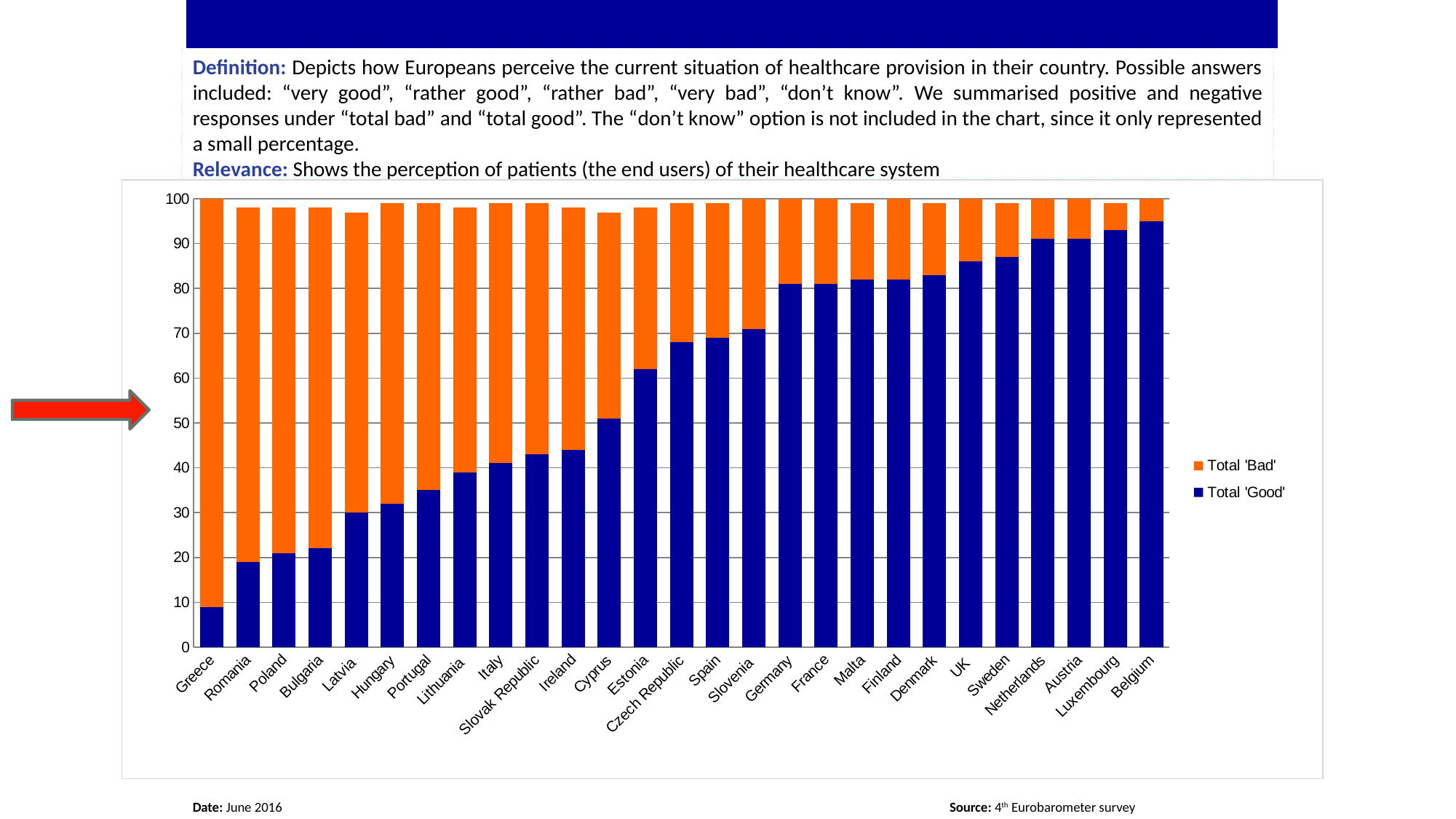
Which country has the larger Total 'Good' value, Germany or Cyprus? Germany How many countries are shown on the x axis of the chart? 27 Which country has the largest Total 'Bad' segment? Greece Is the Total 'Good' value for Belgium greater or less than 90? greater What kind of chart is shown on the slide? Stacked bar chart Is the Total 'Good' value for Greece greater or less than 20? less Is the Total 'Good' value for Ireland greater or less than 40? greater Which country has the lowest Total 'Good' value? Greece Does the Total 'Good' value rise or fall moving from left to right along the x axis? rise How many series does the chart legend list? 2 Which country has the highest Total 'Good' value? Belgium